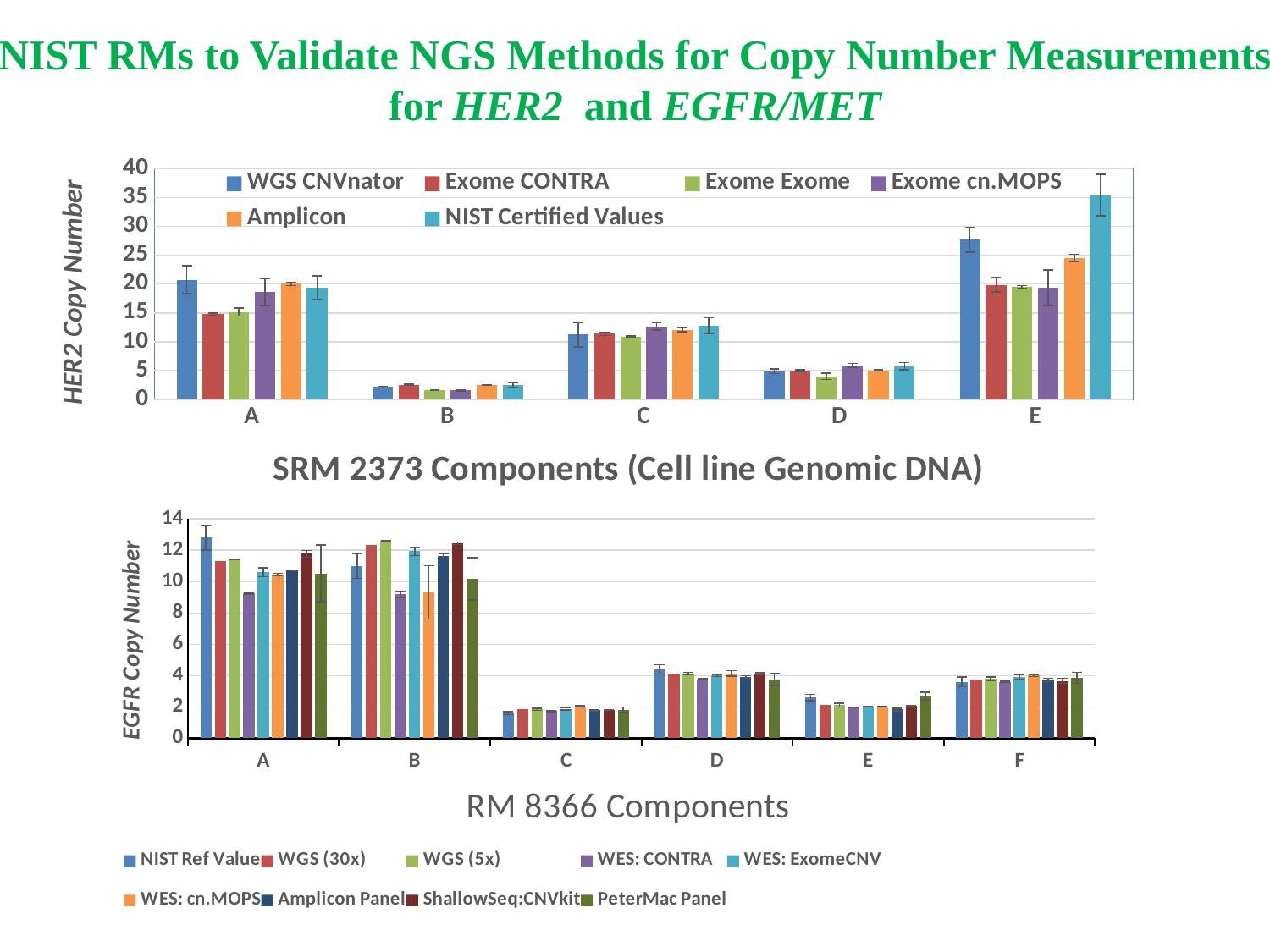
In the top chart (HER2 Copy Number), which series has the highest bar for category E? NIST Certified Values What type of chart is the top chart (HER2 Copy Number)? bar chart In the top chart (HER2 Copy Number), is the WGS CNVnator bar for category A greater or less than 15? greater In the bottom chart (EGFR Copy Number), is the NIST Ref Value bar for category C greater or less than 4? less In the top chart (HER2 Copy Number), which is larger: the WGS CNVnator bar for category A or the Exome CONTRA bar for category A? WGS CNVnator How many categories are shown on the x axis of the bottom chart (EGFR Copy Number)? 6 How many series does the legend of the bottom chart (EGFR Copy Number) list? 9 In the top chart (HER2 Copy Number), is the NIST Certified Values bar for category E greater or less than 30? greater How many series does the legend of the top chart (HER2 Copy Number) list? 6 What is the x-axis title of the bottom chart (EGFR Copy Number)? RM 8366 Components How many categories are shown on the x axis of the top chart (HER2 Copy Number)? 5 In the top chart (HER2 Copy Number), which category has the lowest values across all series? B